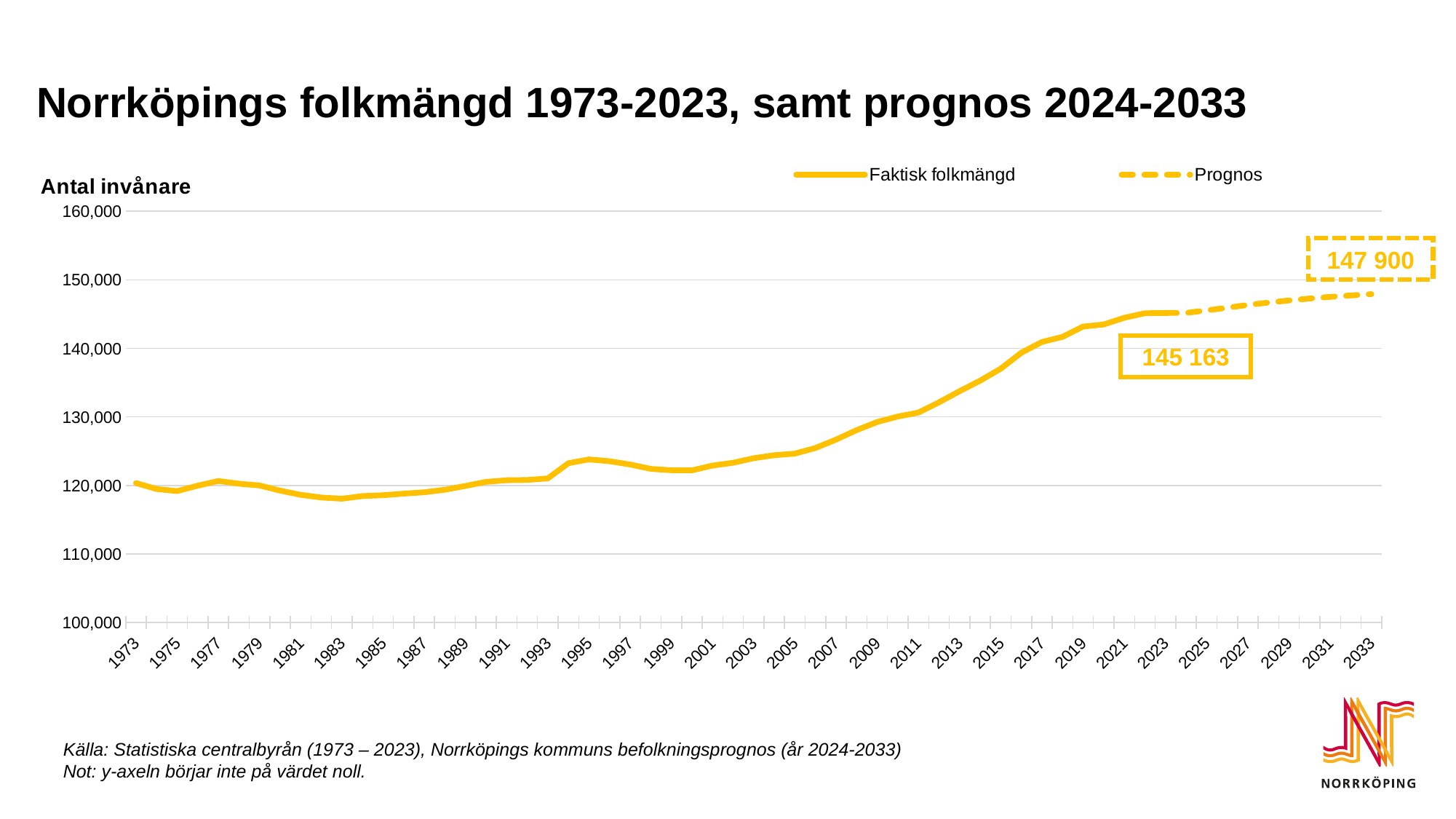
What is the label on the y axis of the chart? Antal invånare What is the actual population (Faktisk folkmängd) value labelled for 2023? 145 163 What is the difference between the 2033 forecast value and the 2023 actual value? 2 737 Is the forecast value for 2029 greater or less than 140,000? greater Which is larger, the 2023 actual value or the 2033 forecast value? 2033 forecast value What are the two legend entries of the chart? Faktisk folkmängd and Prognos What is the forecast (Prognos) value labelled for 2033? 147 900 Does the population rise or fall overall from 1973 to 2023? rise How many series does the legend list? 2 Is the value for 2007 greater or less than 130,000? less What kind of chart is shown on the slide? line chart Is the value for 1983 greater or less than 120,000? less